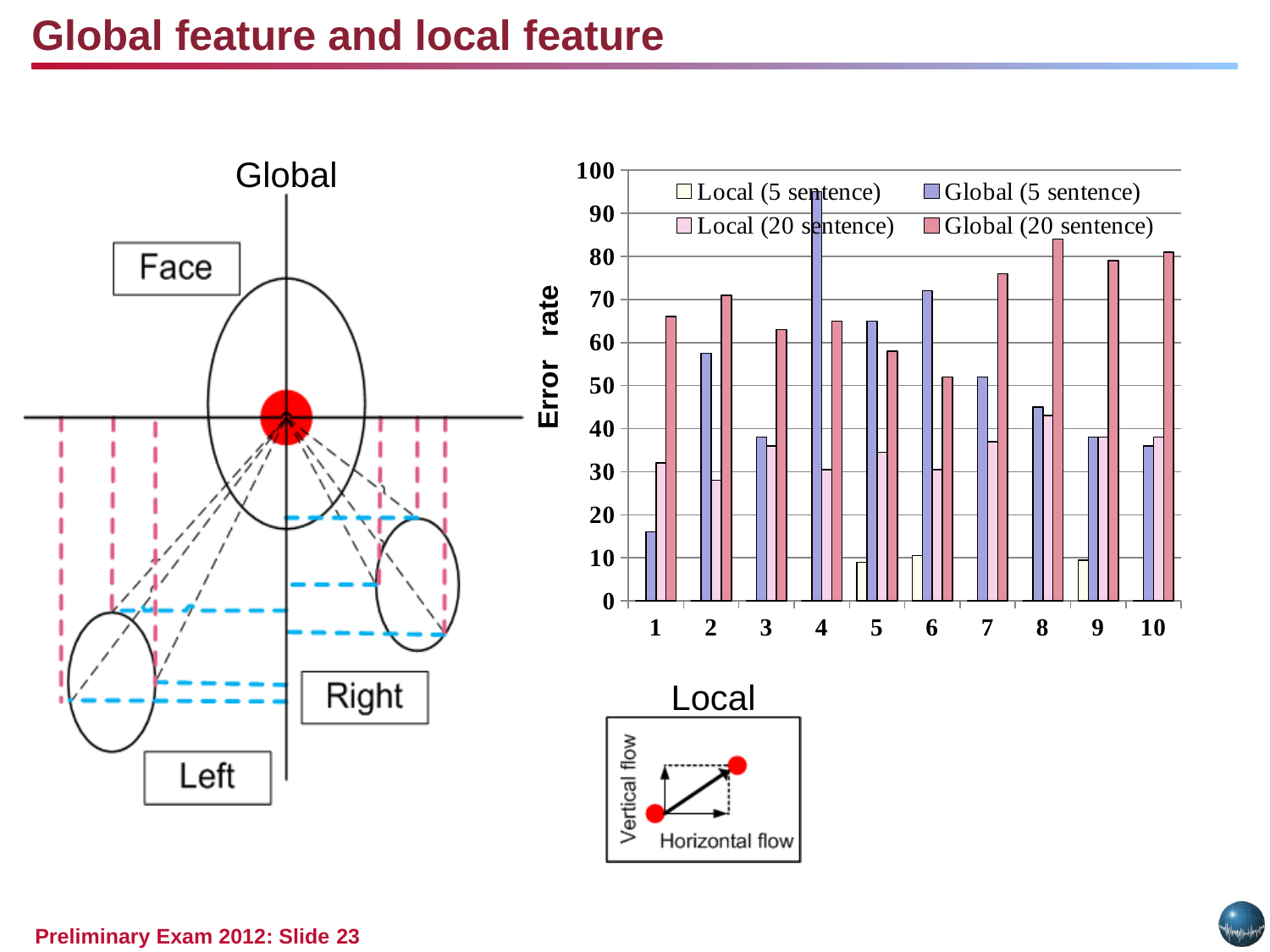
How many series does the chart's legend list? 4 Which series in the legend is drawn in blue? Global (5 sentence) Is the Global (5 sentence) value for category 4 greater or less than 90? greater What is the label of the chart's y axis? Error rate How many categories are shown along the x axis of the chart? 10 For which category is the Global (5 sentence) value lowest? 1 What kind of chart is shown on the slide? bar chart Is the Global (20 sentence) value for category 1 greater or less than 60? greater For which category is the Global (20 sentence) value lowest? 6 For category 2, which is larger: the Global (5 sentence) value or the Local (20 sentence) value? Global (5 sentence) Is the Global (5 sentence) value for category 1 greater or less than 20? less For which category is the Global (5 sentence) value highest? 4